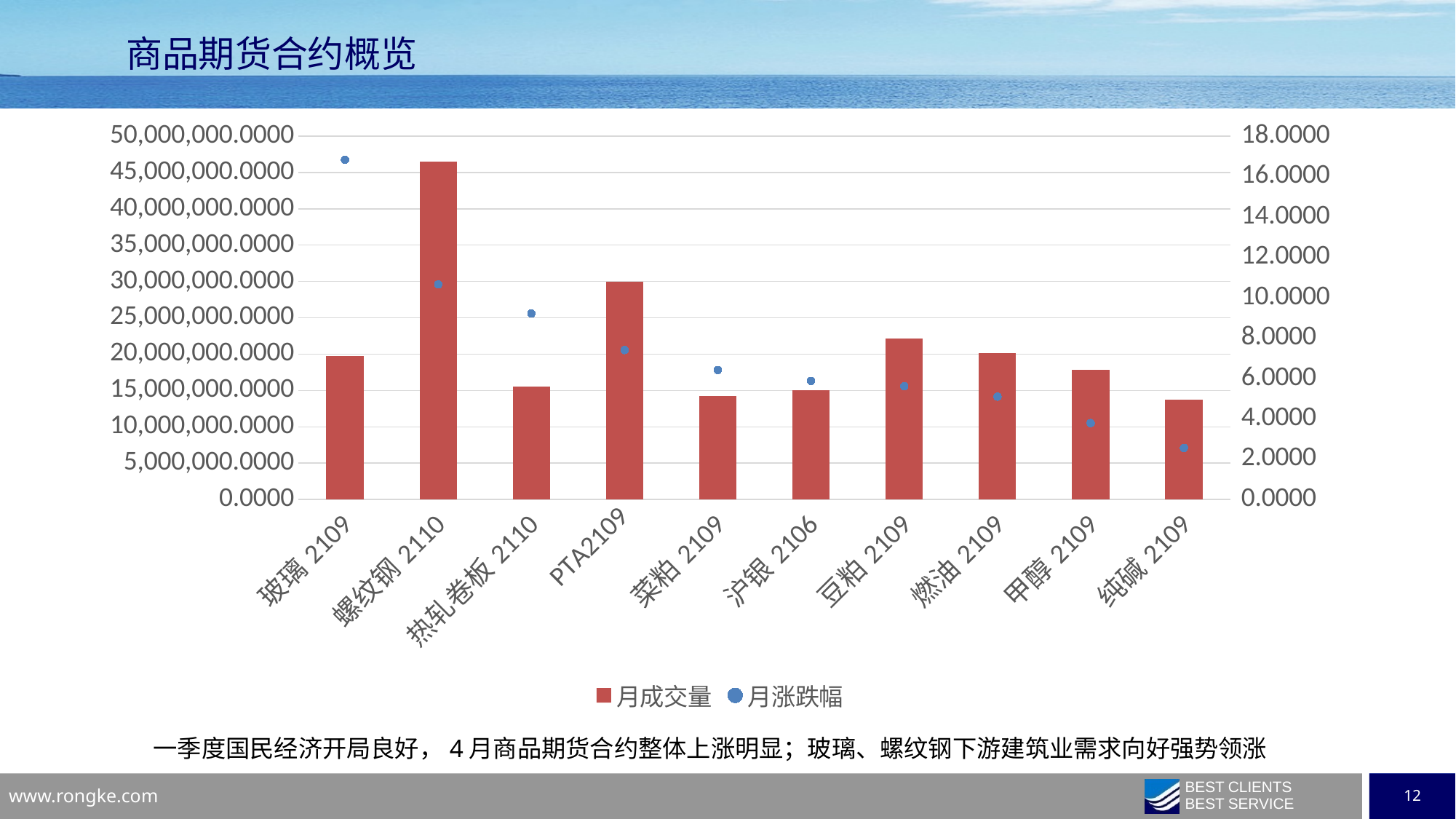
Which has the larger 月成交量 bar, PTA2109 or 豆粕 2109? PTA2109 Which category has the lowest 月涨跌幅 dot? 纯碱 2109 How many series does the chart legend list? 2 How many categories are shown on the x axis of the chart? 10 Which category has the highest 月涨跌幅 dot? 玻璃 2109 Which category has the highest 月成交量 bar? 螺纹钢 2110 Do the 月涨跌幅 dots rise or fall moving from left to right along the x axis? fall Is the 月涨跌幅 value for 纯碱 2109 greater or less than 4.0000? less Is the 月成交量 value for 豆粕 2109 greater or less than 20,000,000.0000? greater What kind of chart is shown on the slide? A bar chart combined with dot markers on a secondary axis What are the two series named in the chart legend? 月成交量 and 月涨跌幅 Is the 月成交量 value for 螺纹钢 2110 greater or less than 40,000,000.0000? greater